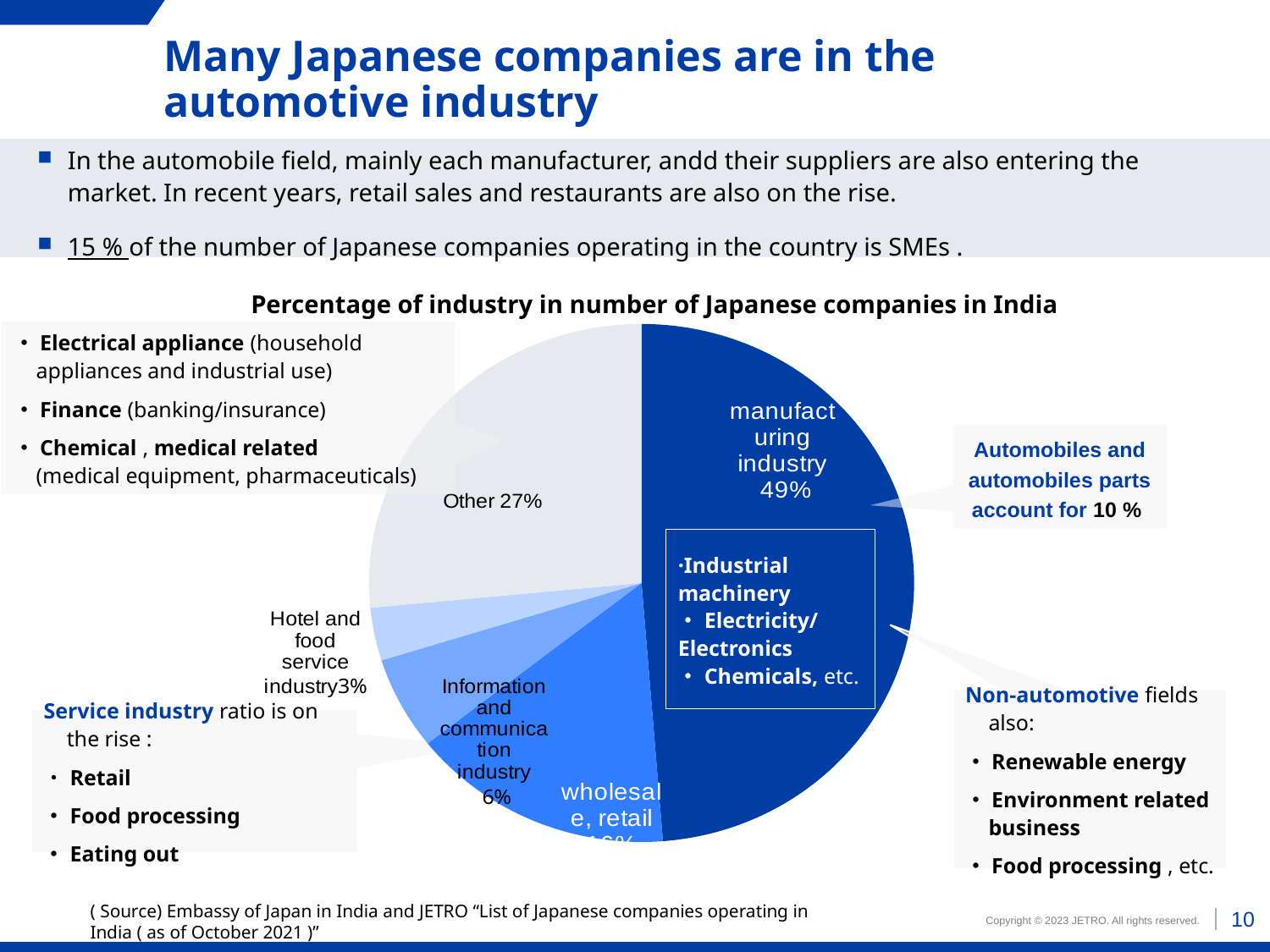
Which slice of the pie is the smallest? Hotel and food service industry What percentage is shown for the Hotel and food service industry? 3% What percentage of the pie does the manufacturing industry account for? 49% How many percentage points larger is the manufacturing industry slice than the Other slice? 22 percentage points Which is larger, the Other slice or the manufacturing industry slice? manufacturing industry How many slices does the pie chart have? 5 What kind of chart is shown on the slide? pie chart What percentage is shown for the Other slice? 27% What percentage is shown for the Information and communication industry? 6% What is the difference between the Information and communication industry share and the Hotel and food service industry share? 3 percentage points Which slice of the pie is the largest? manufacturing industry What is the title of the chart? Percentage of industry in number of Japanese companies in India